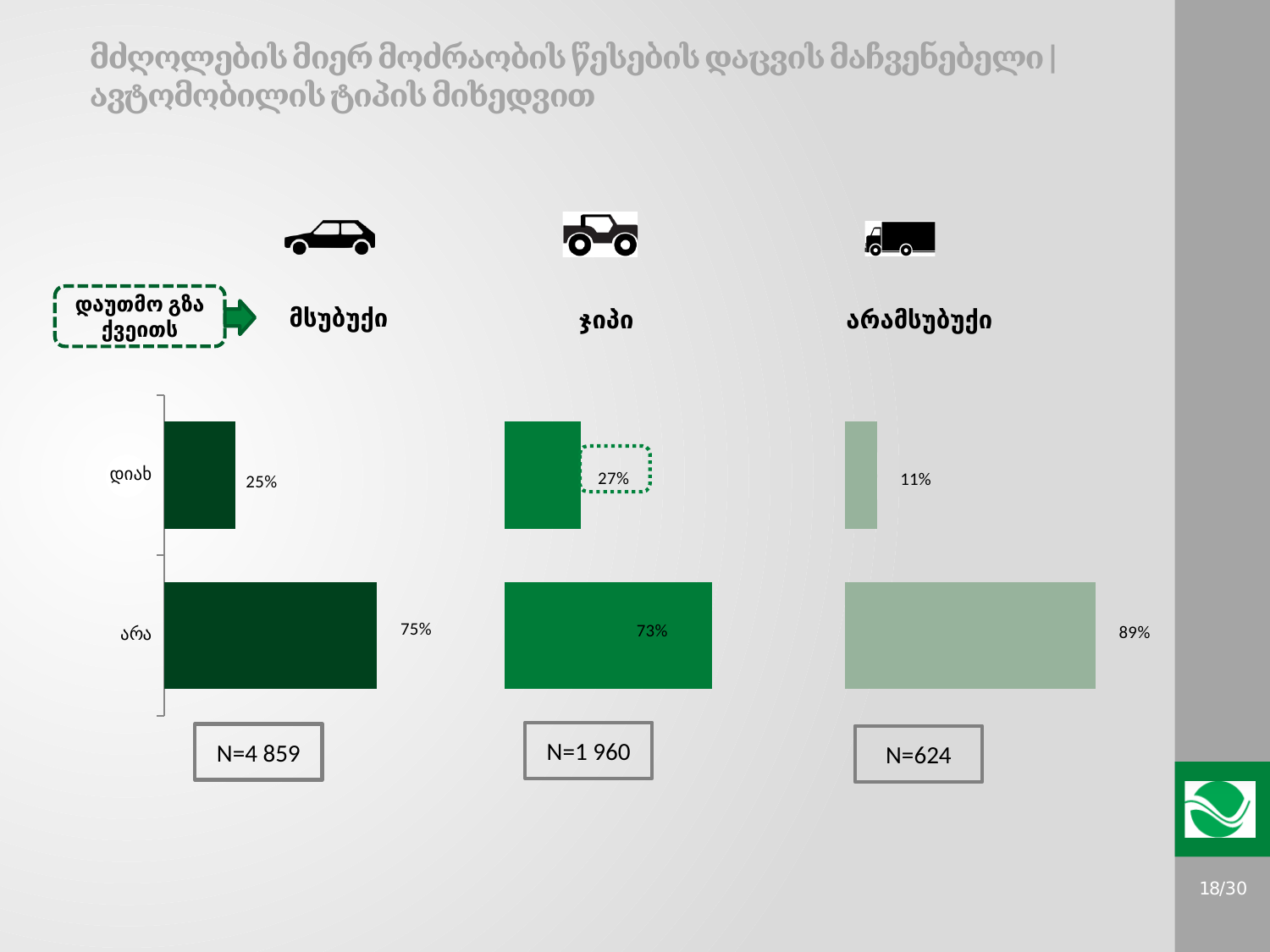
Which is larger: the დიახ value in the ჯიპი chart or the დიახ value in the არამსუბუქი chart? ჯიპი In the არამსუბუქი chart, what is the value for არა? 89% In the მსუბუქი chart, what is the value for არა? 75% In the მსუბუქი chart, what is the value for დიახ? 25% How many categories does the მსუბუქი chart show? 2 What type of chart is used for the ჯიპი data? Bar chart In the არამსუბუქი chart, what is the value for დიახ? 11% In the ჯიპი chart, which category has the lowest value? დიახ In the არამსუბუქი chart, which category has the highest value? არა In the ჯიპი chart, what is the value for დიახ? 27% In the ჯიპი chart, what is the value for არა? 73% In the მსუბუქი chart, what is the difference between the values for არა and დიახ? 50%